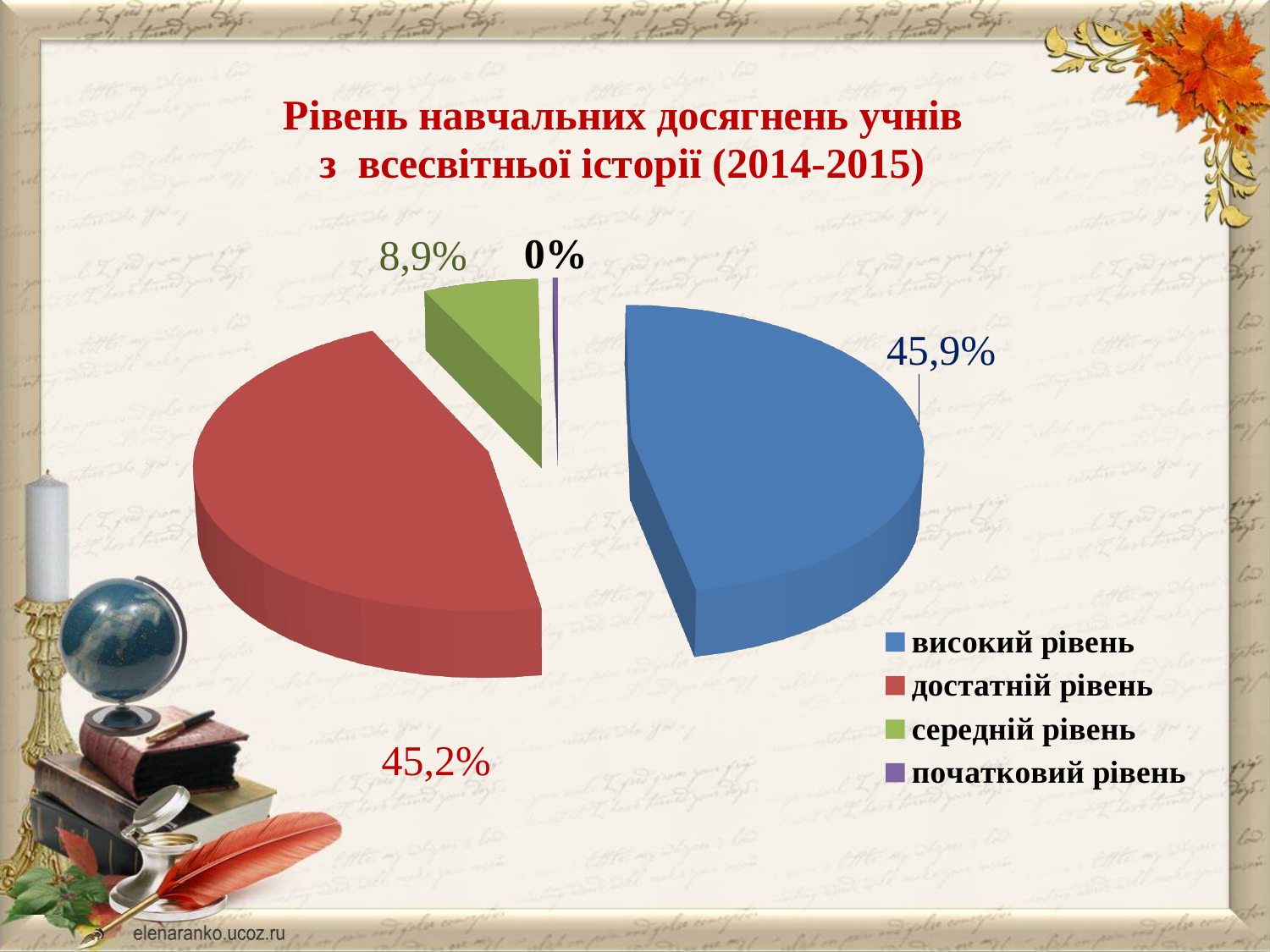
Which category has the largest share of the pie? високий рівень What share of the pie is labelled for початковий рівень? 0% What share of the pie is labelled for високий рівень? 45,9% What share of the pie is labelled for середній рівень? 8,9% What is the difference between the shares for високий рівень and достатній рівень? 0,7% How many categories does the legend list? 4 What colour is the slice for середній рівень? green What share of the pie is labelled for достатній рівень? 45,2% Which category has the smallest share of the pie? початковий рівень Which is larger, the share for середній рівень or the share for достатній рівень? достатній рівень What is the difference between the shares for достатній рівень and середній рівень? 36,3% What kind of chart is shown on the slide? pie chart